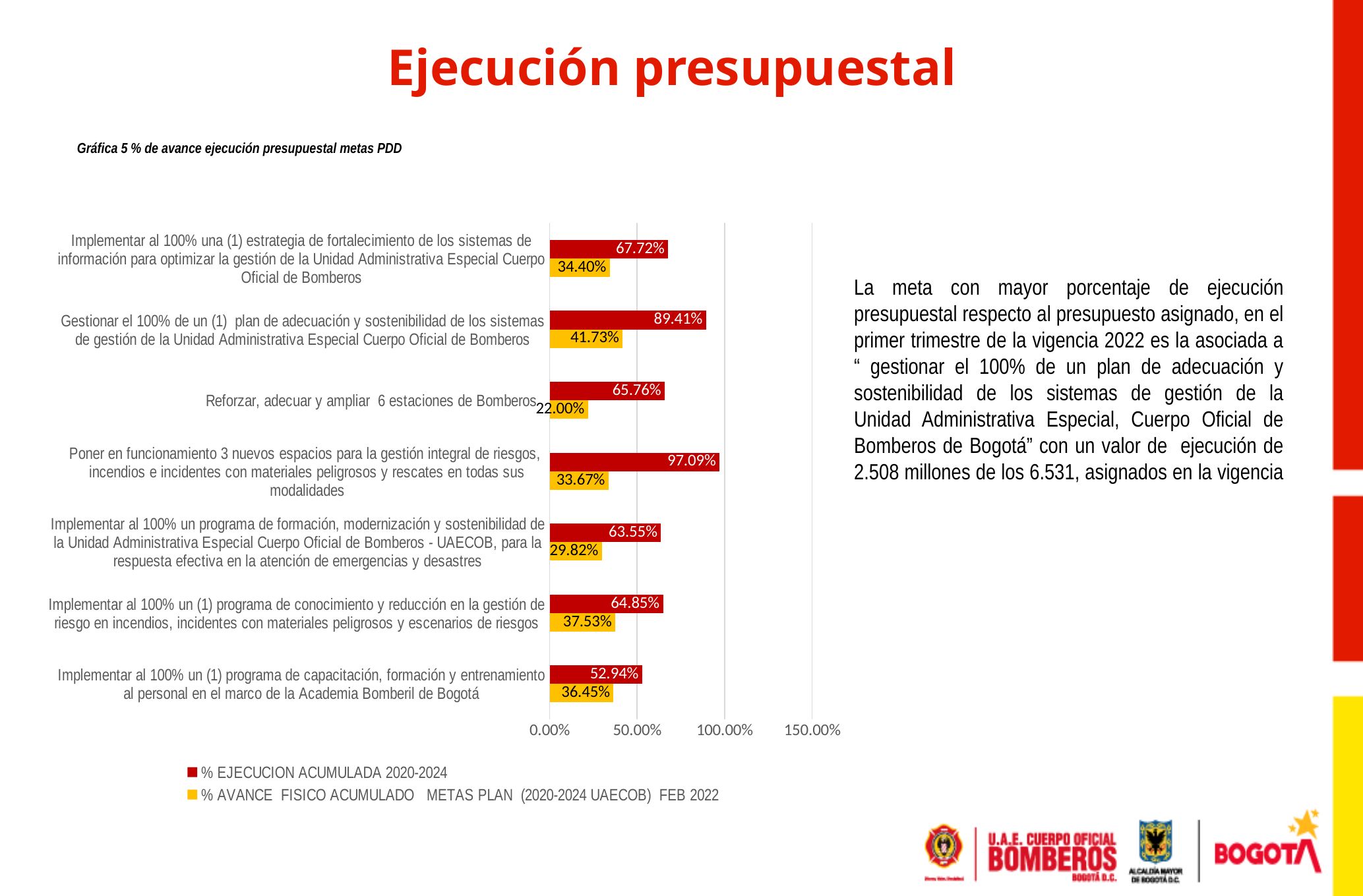
Which colour represents the series '% EJECUCION ACUMULADA 2020-2024' in the chart? Red Which category has the lowest % EJECUCION ACUMULADA 2020-2024 value? Implementar al 100% un (1) programa de capacitación, formación y entrenamiento al personal en el marco de la Academia Bomberil de Bogotá Is the % EJECUCION ACUMULADA 2020-2024 value for 'Gestionar el 100% de un (1) plan de adecuación y sostenibilidad' greater or less than 50.00%? greater Which category has the lowest % AVANCE FISICO ACUMULADO value? Reforzar, adecuar y ampliar 6 estaciones de Bomberos What is the difference between the % EJECUCION ACUMULADA and the % AVANCE FISICO ACUMULADO for 'Poner en funcionamiento 3 nuevos espacios para la gestión integral de riesgos'? 63.42% What is the % EJECUCION ACUMULADA 2020-2024 value for 'Reforzar, adecuar y ampliar 6 estaciones de Bomberos'? 65.76% What is the % AVANCE FISICO ACUMULADO value for 'Gestionar el 100% de un (1) plan de adecuación y sostenibilidad de los sistemas de gestión'? 41.73% How many categories (metas) are plotted in the chart? 7 How many series does the chart legend list? 2 What type of chart is shown on the slide? Bar chart Which is larger: the % AVANCE FISICO ACUMULADO for 'Implementar al 100% un (1) programa de conocimiento y reducción en la gestión de riesgo' or for 'Implementar al 100% una (1) estrategia de fortalecimiento de los sistemas de información'? Implementar al 100% un (1) programa de conocimiento y reducción en la gestión de riesgo (37.53%) Which category has the highest % EJECUCION ACUMULADA 2020-2024 value? Poner en funcionamiento 3 nuevos espacios para la gestión integral de riesgos, incendios e incidentes con materiales peligrosos y rescates en todas sus modalidades